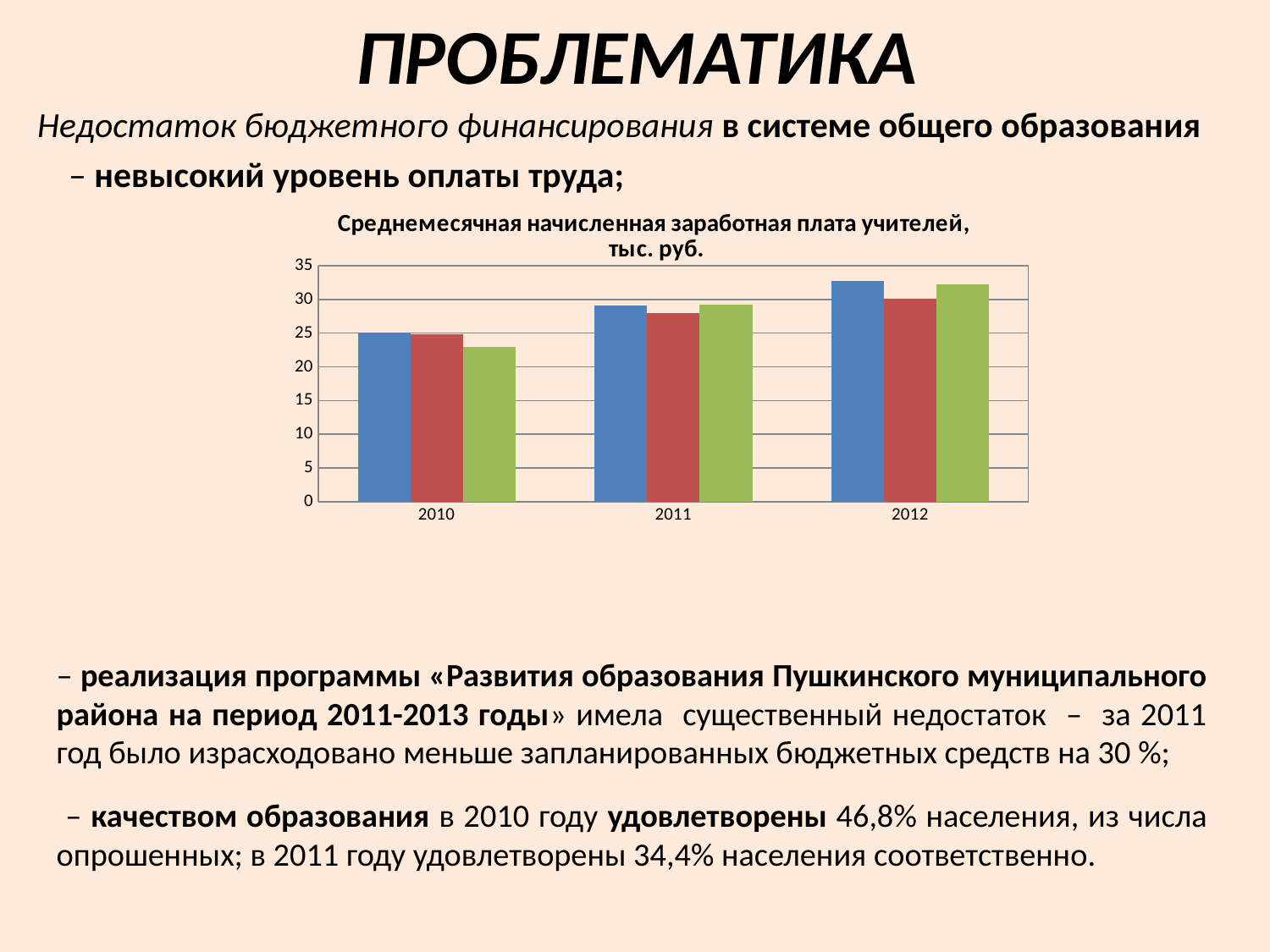
What is the title of the chart? Среднемесячная начисленная заработная плата учителей, тыс. руб. How many bars are plotted for each year in the chart? 3 How many years are shown on the x axis of the chart? 3 Is the value of the green bar for 2012 greater or less than 30? greater Is the value of the red bar for 2011 greater or less than 30? less What kind of chart is shown on the slide? bar chart Is the value of the green bar for 2010 greater or less than 25? less Which year has the lowest green bar? 2010 Which year has the highest blue bar? 2012 Do the blue bars rise or fall from 2010 to 2012? rise